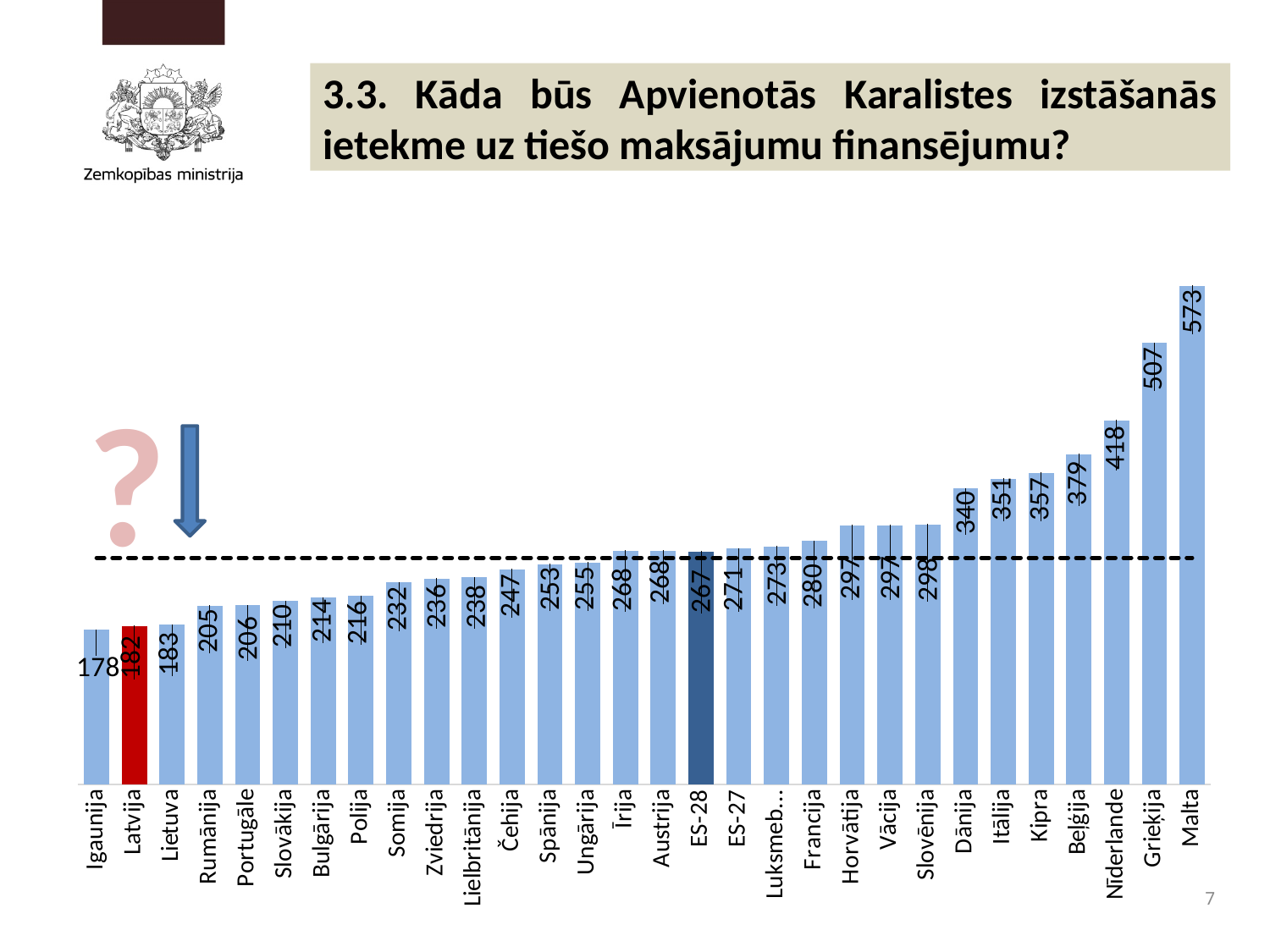
What is the value for ES-28? 267 How many categories are shown on the x axis? 30 What is the difference between the values for Malta and Igaunija? 395 What is the value for Lielbritānija? 238 What is the difference between the values for ES-27 and ES-28? 4 Which is larger, the value for Dānija or the value for Slovēnija? Dānija Which category has the lowest value? Igaunija Which category has the highest value? Malta What is the value for Latvija? 182 Do the values rise or fall from left to right along the x axis? rise What kind of chart is shown on the slide? bar chart What is the value for Malta? 573